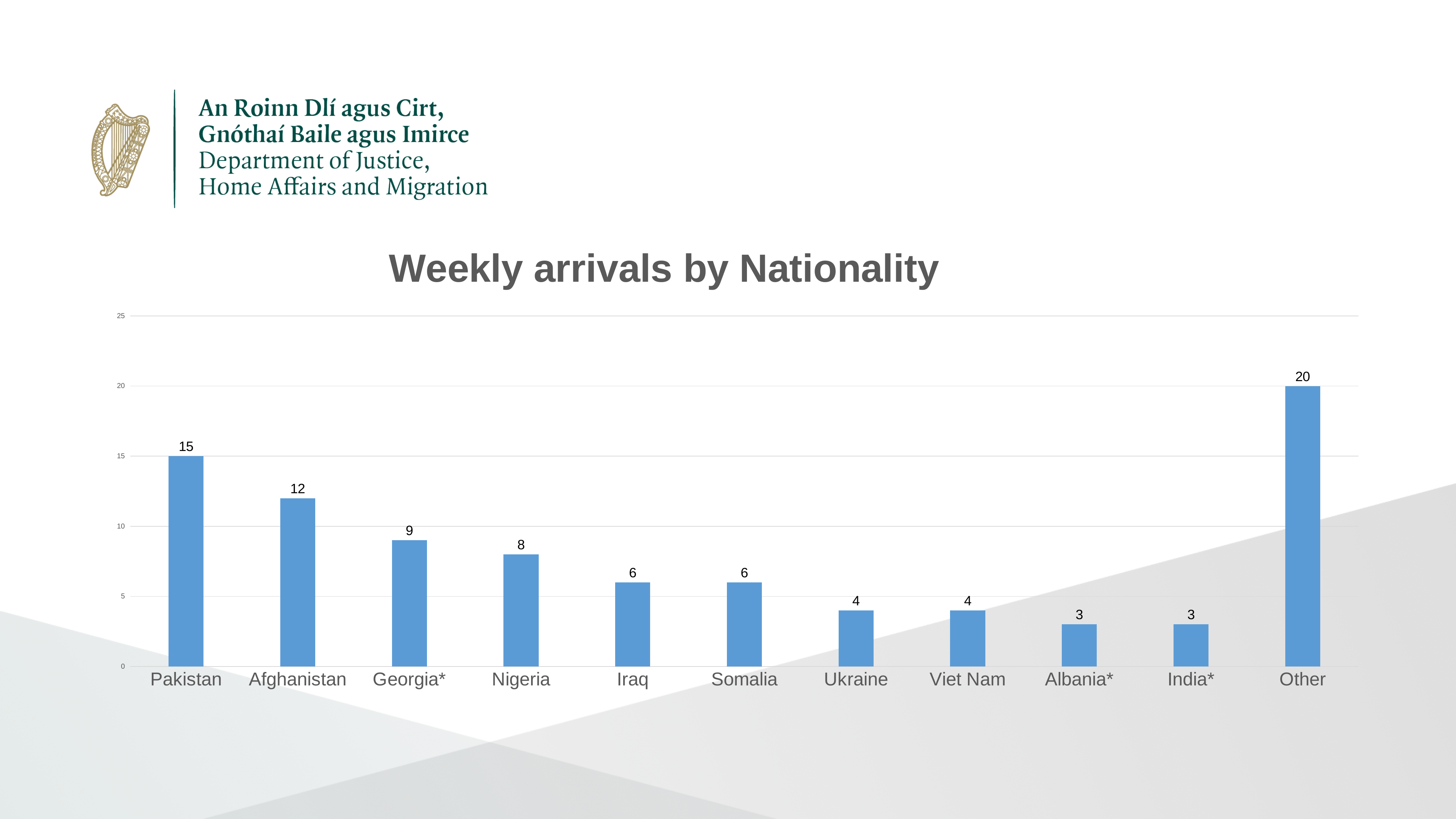
Which named nationality (excluding Other) has the highest value? Pakistan What is the value for Afghanistan? 12 What kind of chart is this? Bar chart What is the difference between the values for Pakistan and Afghanistan? 3 What is the title of the chart? Weekly arrivals by Nationality What is the value for Ukraine? 4 What is the value for Nigeria? 8 Which category has the highest value? Other How many categories are shown on the x axis? 11 What is the difference between the values for Other and Georgia*? 11 Which is larger, the value for Iraq or the value for Viet Nam? Iraq What is the value for Pakistan? 15